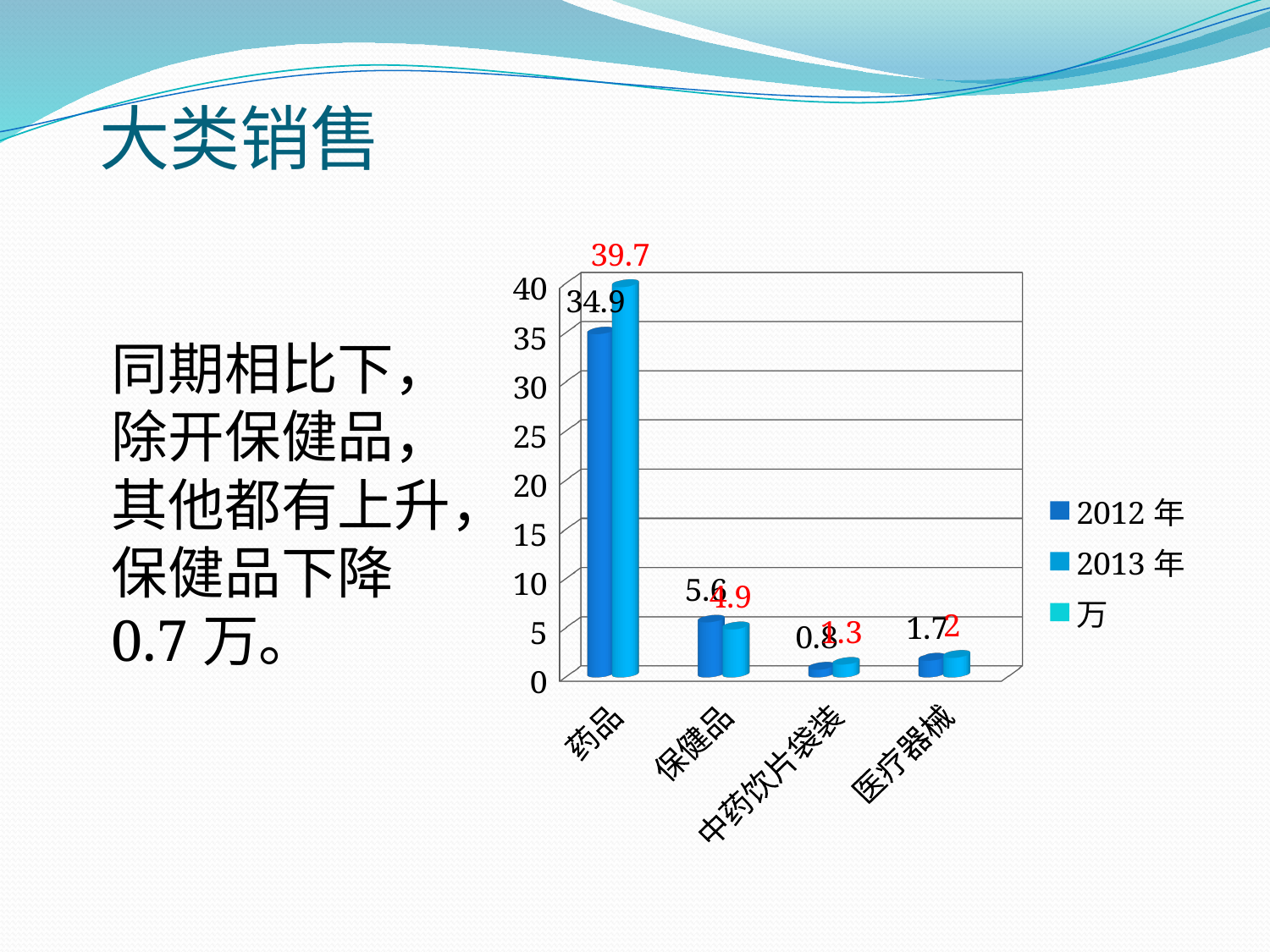
Which category has the highest 2013 年 value? 药品 What is the 2013 年 value for 医疗器械? 2 How many categories are shown on the x axis? 4 What type of chart is shown on the slide? bar chart What is the 2013 年 value for 保健品? 4.9 What is the 2013 年 value for 中药饮片袋装? 1.3 How many entries does the legend list? 3 What is the difference between the 2013 年 and 2012 年 values for 药品? 4.8 What is the 2012 年 value for 药品? 34.9 Which is larger for 保健品, the 2012 年 value or the 2013 年 value? 2012 年 What is the 2012 年 value for 保健品? 5.6 What is the 2013 年 value for 药品? 39.7